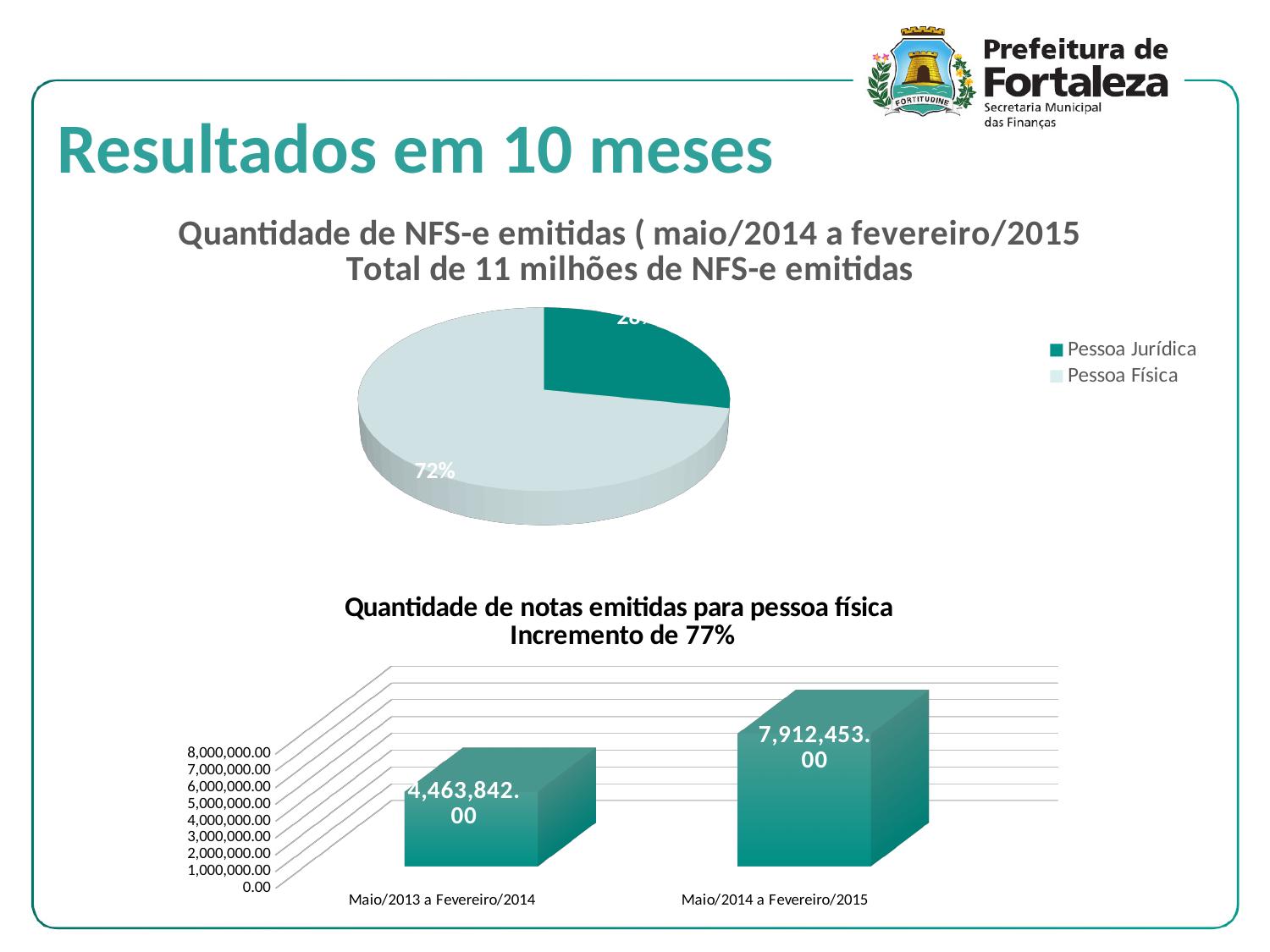
In the bottom chart 'Quantidade de notas emitidas para pessoa física', which period has the highest value? Maio/2014 a Fevereiro/2015 In the bottom chart 'Quantidade de notas emitidas para pessoa física', what is the value for Maio/2014 a Fevereiro/2015? 7,912,453.00 In the bottom chart 'Quantidade de notas emitidas para pessoa física', how many bars are plotted? 2 In the pie chart at the top of the slide, which category has the larger slice, Pessoa Jurídica or Pessoa Física? Pessoa Física In the bottom chart 'Quantidade de notas emitidas para pessoa física', do the values rise or fall from Maio/2013 a Fevereiro/2014 to Maio/2014 a Fevereiro/2015? Rise In the pie chart at the top of the slide, what share of NFS-e emitidas corresponds to Pessoa Física? 72% In the pie chart at the top of the slide, which legend entry is shown in the darker teal colour? Pessoa Jurídica What kind of chart is the bottom chart on the slide? Bar chart What kind of chart is the top chart on the slide? Pie chart In the bottom chart 'Quantidade de notas emitidas para pessoa física', what is the difference between the value for Maio/2014 a Fevereiro/2015 and the value for Maio/2013 a Fevereiro/2014? 3,448,611.00 In the bottom chart 'Quantidade de notas emitidas para pessoa física', what is the value for Maio/2013 a Fevereiro/2014? 4,463,842.00 How many entries does the legend of the pie chart at the top of the slide list? 2